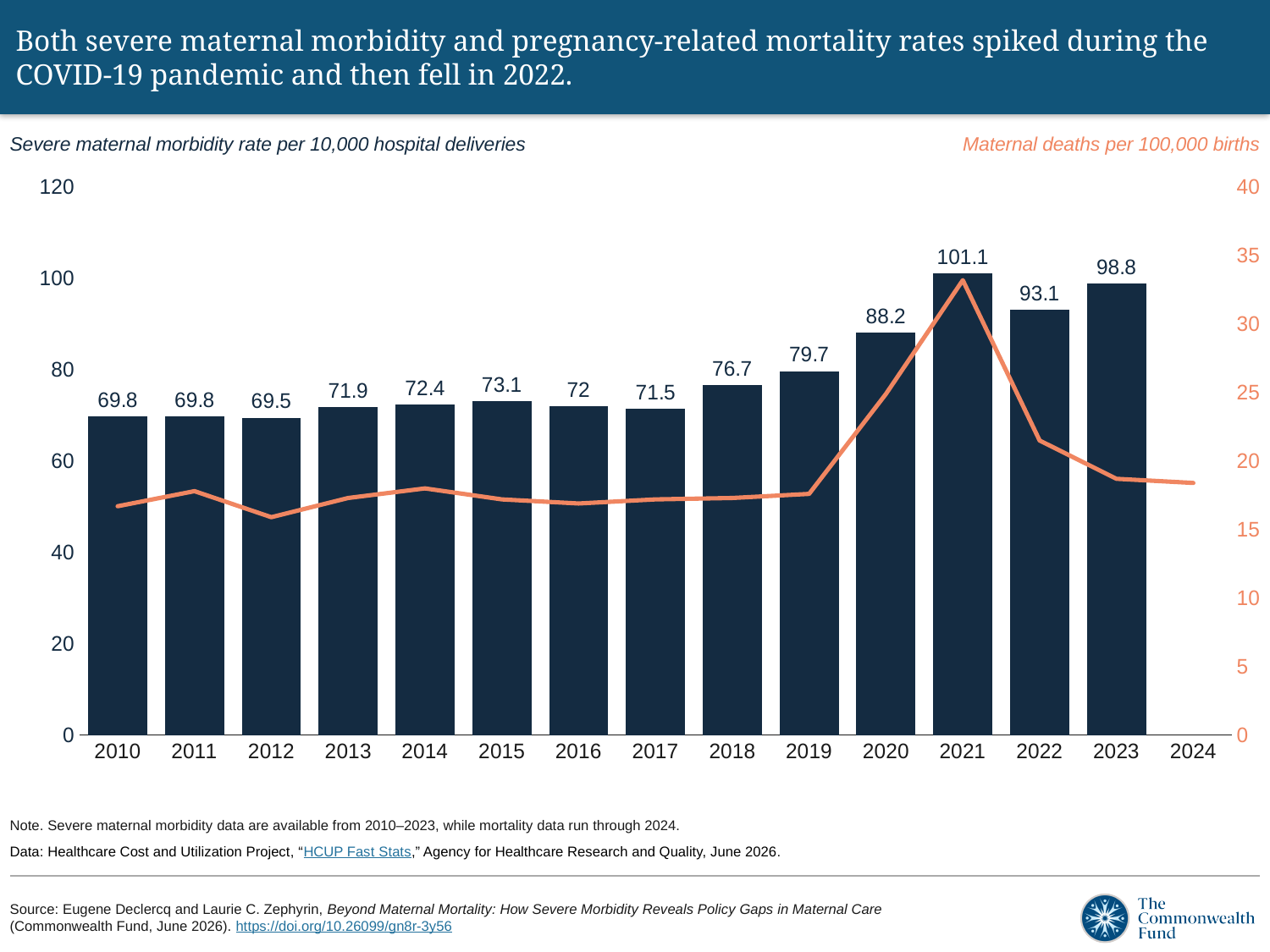
Which year has the highest severe maternal morbidity rate bar? 2021 Is the maternal deaths per 100,000 births value for 2012 greater or less than 20? less How many years have a severe maternal morbidity rate bar on the chart? 14 Which year has the lowest severe maternal morbidity rate bar? 2012 What is the severe maternal morbidity rate per 10,000 hospital deliveries in 2021? 101.1 By how much did the severe maternal morbidity rate increase from 2020 to 2021? 12.9 Which year has the higher severe maternal morbidity rate, 2022 or 2023? 2023 Did the severe maternal morbidity rate rise or fall from 2018 to 2021? Rise What is the difference between the severe maternal morbidity rates in 2023 and 2022? 5.7 What is the severe maternal morbidity rate per 10,000 hospital deliveries in 2019? 79.7 What kind of chart is shown on the slide? A combination bar and line chart Is the maternal deaths per 100,000 births value for 2021 greater or less than 30? greater